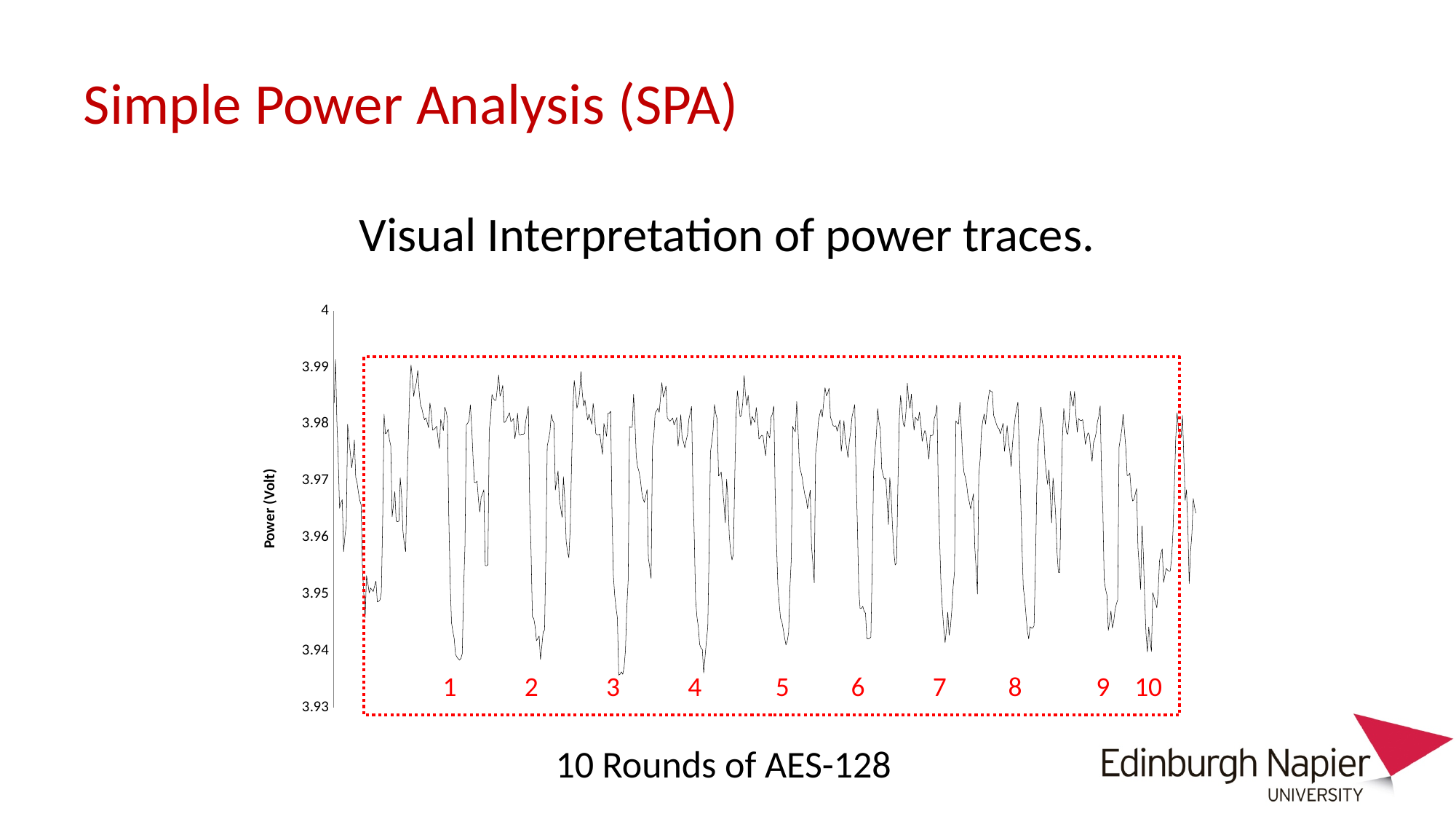
What is the lowest tick value shown on the vertical axis? 3.93 What is the label on the vertical axis of the chart? Power (Volt) Does the power trace ever reach a value greater or less than 4 volts? less What kind of chart is shown on the slide? line chart Is the deepest dip in the trace near round 3 greater or less than 3.95? less What does the caption below the chart say the trace represents? 10 Rounds of AES-128 What is the highest tick value shown on the vertical axis? 4 Is the highest point of the power trace greater or less than 3.98? greater How many series are plotted on the chart? 1 How many rounds are numbered in red inside the dotted box on the chart? 10